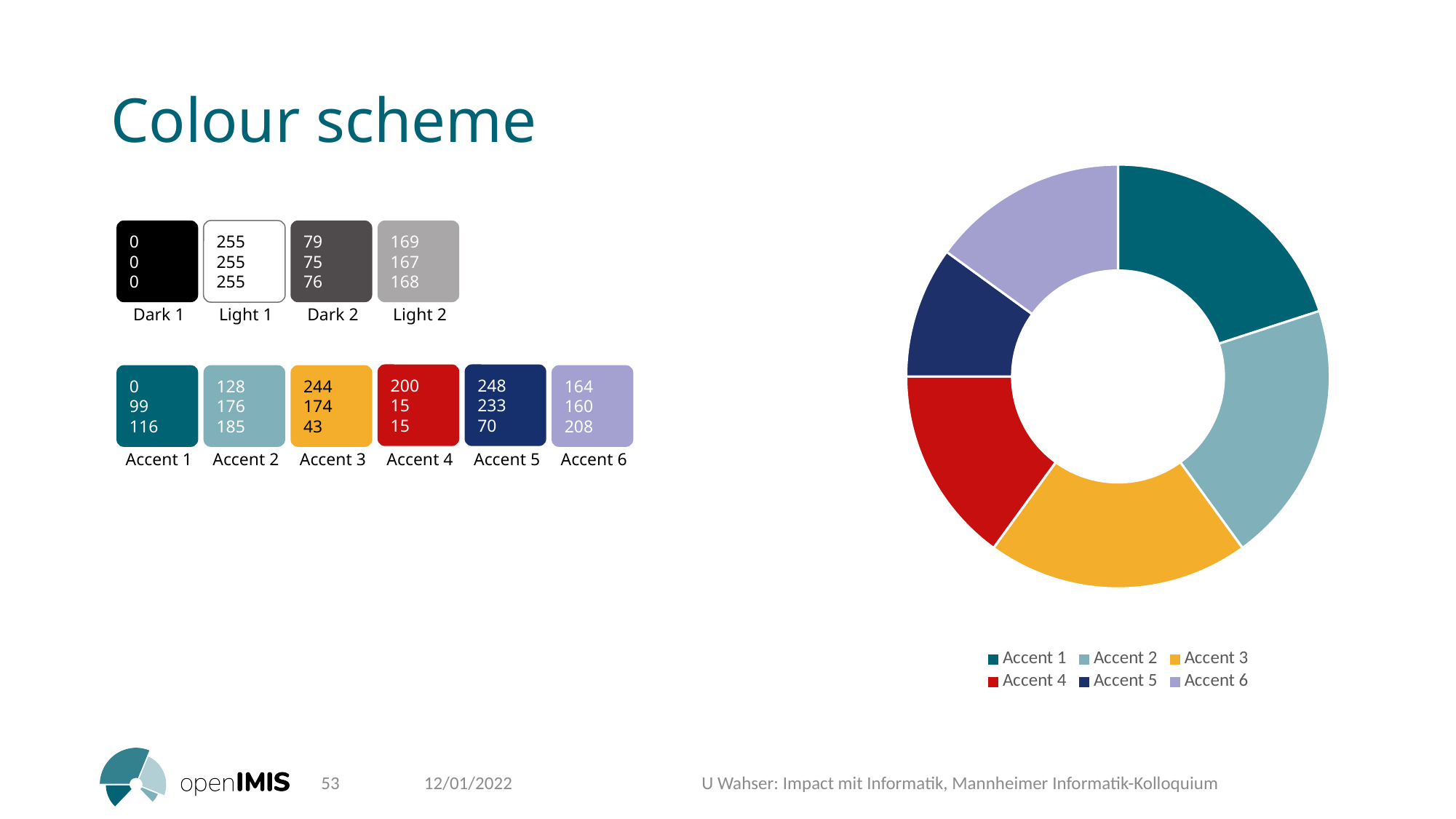
What colour is the Accent 3 slice in the doughnut chart? yellow/orange How many entries does the legend of the doughnut chart list? 6 In the doughnut chart, which slice is larger, Accent 6 or Accent 5? Accent 6 How many slices does the doughnut chart have? 6 In the doughnut chart, which slice is larger, Accent 3 or Accent 4? Accent 3 In the doughnut chart, which slice is larger, Accent 4 or Accent 5? Accent 4 Which slice of the doughnut chart is the smallest? Accent 5 Which legend entry of the doughnut chart is shown in red? Accent 4 What kind of chart is shown on the right of the slide? doughnut (pie) chart